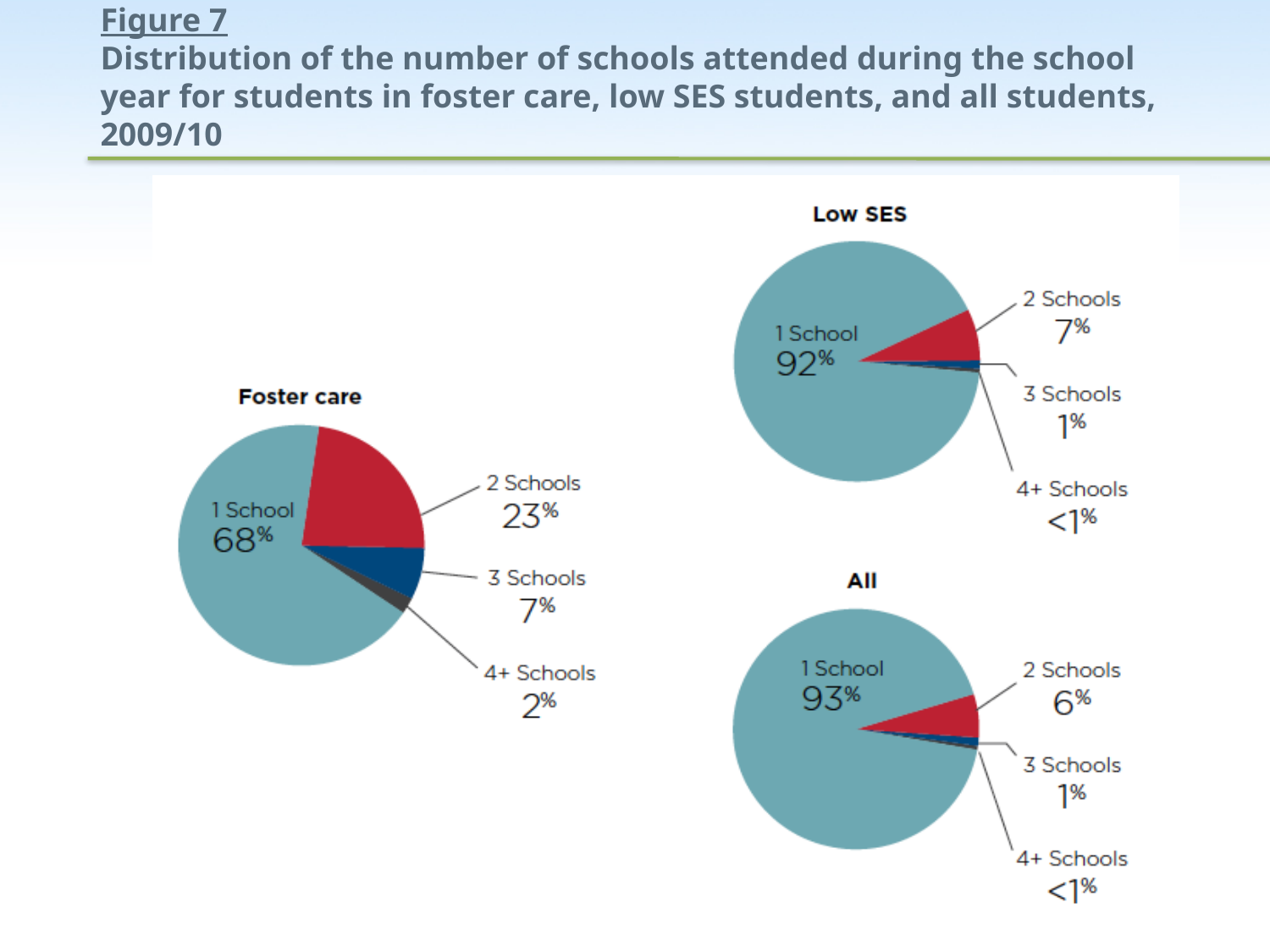
In the Foster care pie chart, what percentage of students attended 1 School? 68% How many categories does the Foster care pie chart show? 4 What type of chart is used for the Low SES data? Pie chart In the Foster care pie chart, what percentage of students attended 4+ Schools? 2% In the Low SES pie chart, what percentage of students attended 1 School? 92% Which is larger: the 3 Schools share in the Foster care chart or the 3 Schools share in the All chart? Foster care In the Foster care pie chart, which category has the largest share? 1 School What is the difference between the 2 Schools share in the Foster care chart and the 2 Schools share in the Low SES chart? 16% How many pie charts are shown on the slide? 3 In the Foster care pie chart, what percentage of students attended 2 Schools? 23% In the Low SES pie chart, which category has the smallest share? 4+ Schools In the All pie chart, what percentage of students attended 2 Schools? 6%